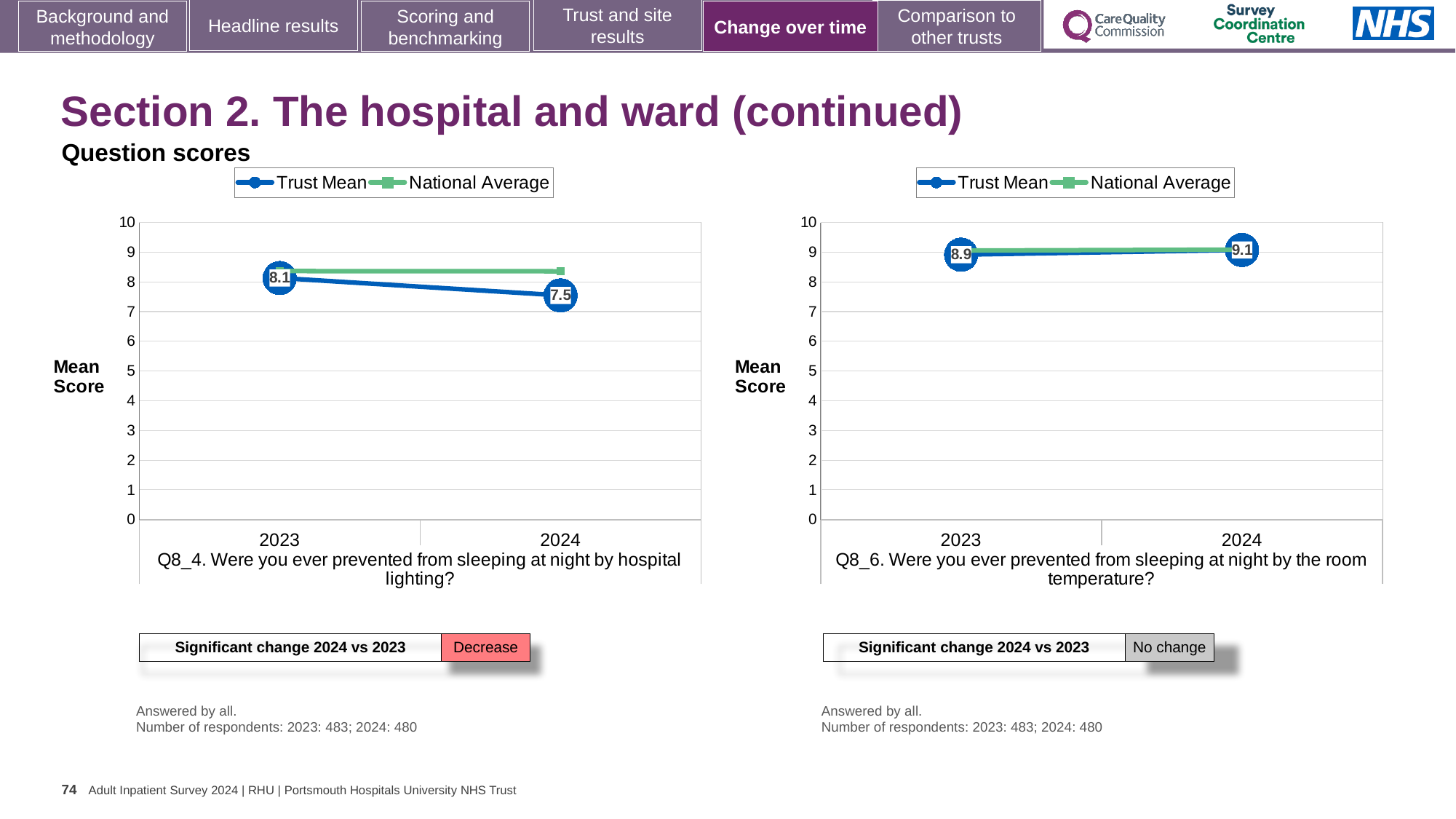
In the left chart (Q8_4, hospital lighting), what is the Trust Mean score for 2023? 8.1 In the right chart (Q8_6, room temperature), what is the Trust Mean score for 2024? 9.1 In the right chart (Q8_6, room temperature), what is the Trust Mean score for 2023? 8.9 In the right chart (Q8_6, room temperature), what is the difference between the Trust Mean for 2024 and 2023? 0.2 In the left chart (Q8_4, hospital lighting), by how much did the Trust Mean fall from 2023 to 2024? 0.6 What kind of chart is the left chart (Q8_4, hospital lighting)? line chart In the left chart (Q8_4, hospital lighting), is the National Average for 2024 greater or less than 8? greater In the left chart (Q8_4, hospital lighting), does the Trust Mean rise or fall from 2023 to 2024? fall How many series does the legend of the right chart (Q8_6, room temperature) list? 2 In the left chart (Q8_4, hospital lighting), what is the Trust Mean score for 2024? 7.5 In the right chart (Q8_6, room temperature), does the Trust Mean rise or fall from 2023 to 2024? rise In the left chart (Q8_4, hospital lighting), which year has the higher Trust Mean, 2023 or 2024? 2023